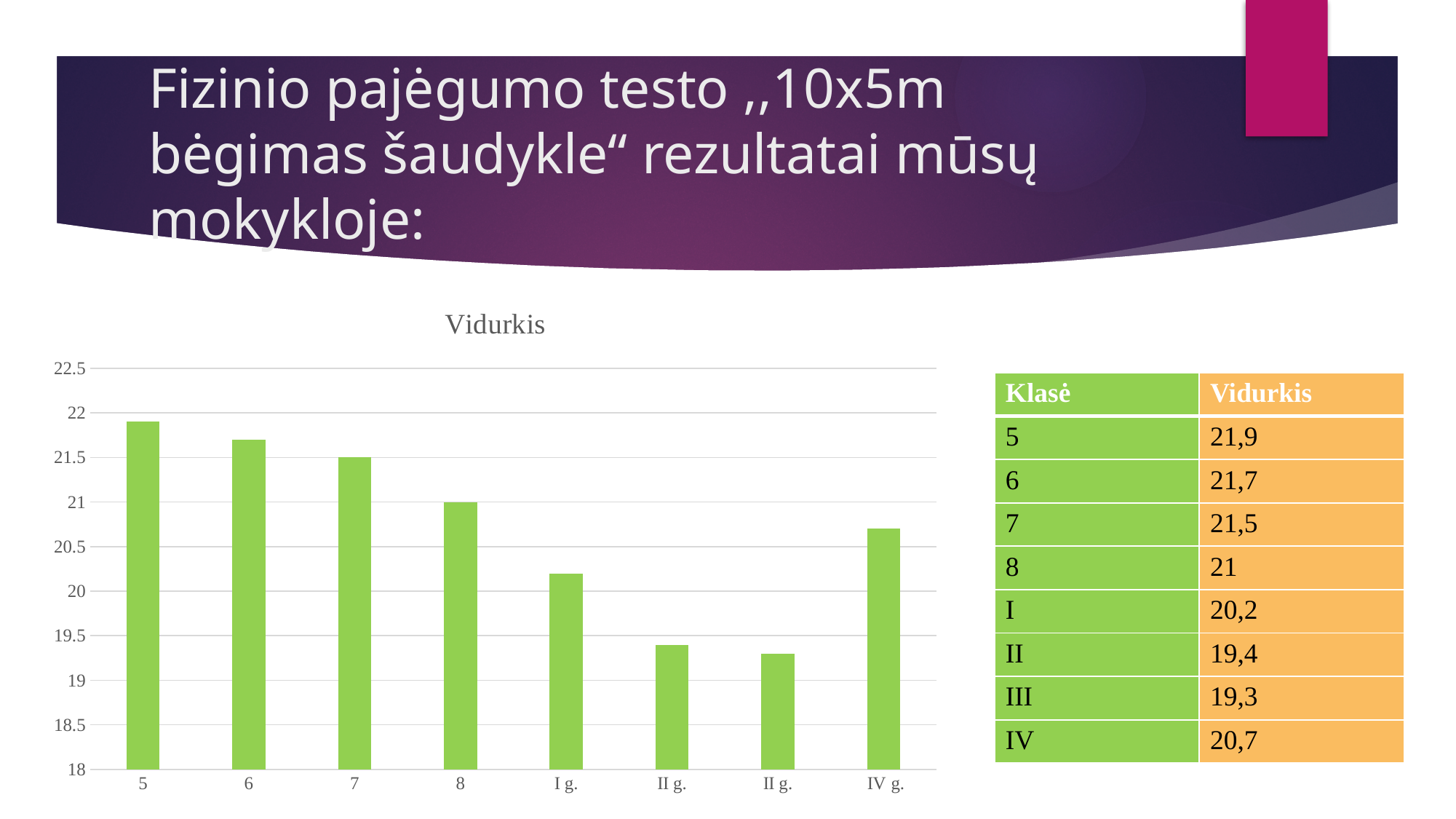
What kind of chart is shown on the slide? bar chart What is the difference between the values for class 8 and I g.? 0,8 Which category has the highest bar in the Vidurkis chart? 5 What is the value for IV g. in the Vidurkis chart? 20,7 Which is larger, the value for class 7 or the value for IV g.? 7 What is the value for class 5 in the Vidurkis chart? 21,9 What is the value for class 8 in the Vidurkis chart? 21 Do the values rise or fall from class 5 to class 8? fall How many bars are shown in the Vidurkis chart? 8 Is the value for I g. greater or less than 20? greater Is the value for II g. greater or less than 19.5? less What is the difference between the values for class 5 and class 6? 0,2